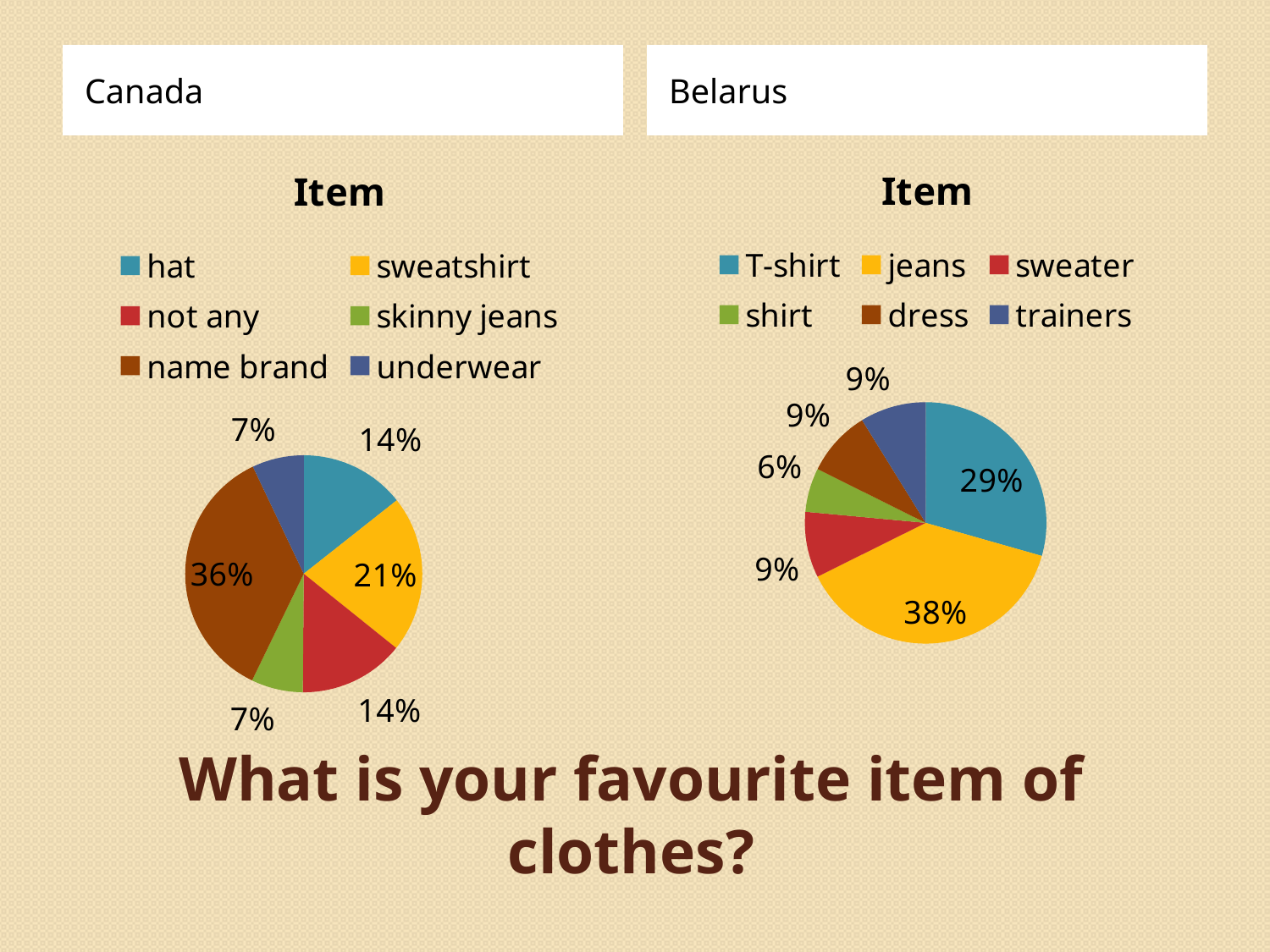
In the Belarus chart, what share of the pie is jeans? 38% In the Belarus chart, which colour represents T-shirt? teal In the Canada chart, what percentage is shown for sweatshirt? 21% In the Canada chart, which is larger, hat or skinny jeans? hat In the Canada chart, what is the difference in percentage points between name brand and sweatshirt? 15 How many slices does the Belarus pie chart have? 6 In the Belarus chart, what is the difference in percentage points between jeans and T-shirt? 9 In the Canada chart, which item has the largest slice? name brand In the Belarus chart, what percentage is shown for shirt? 6% What type of chart is used for Canada? pie chart In the Canada chart, what share of the pie is name brand? 36% In the Belarus chart, which item has the smallest slice? shirt